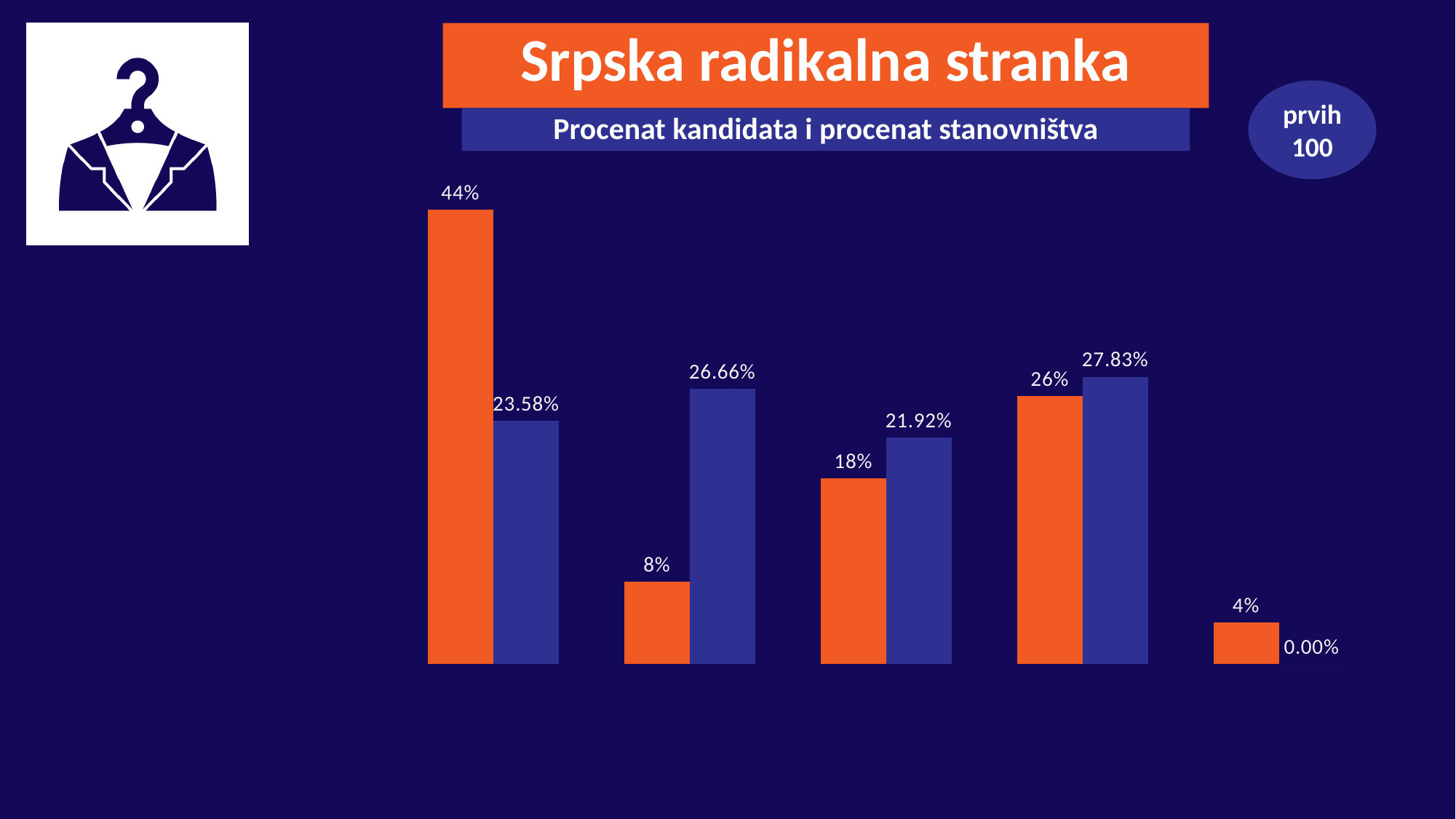
What is the subtitle shown below the main title of the chart? Procenat kandidata i procenat stanovništva What is the highest value shown among the orange bars? 44% What is the value of the orange bar in the leftmost group? 44% How many groups of bars does the chart show? 5 In the leftmost group, what is the difference between the orange bar and the blue bar? 20.42% What is the lowest value shown among the blue bars? 0.00% What is the value of the orange bar in the third group from the left? 18% What is the value of the blue bar in the second group from the left? 26.66% What is the value of the blue bar in the rightmost group? 0.00% What kind of chart is shown on the slide? bar chart In the fourth group from the left, which bar is larger, the orange one or the blue one? the blue one In the second group from the left, what is the difference between the blue bar and the orange bar? 18.66%